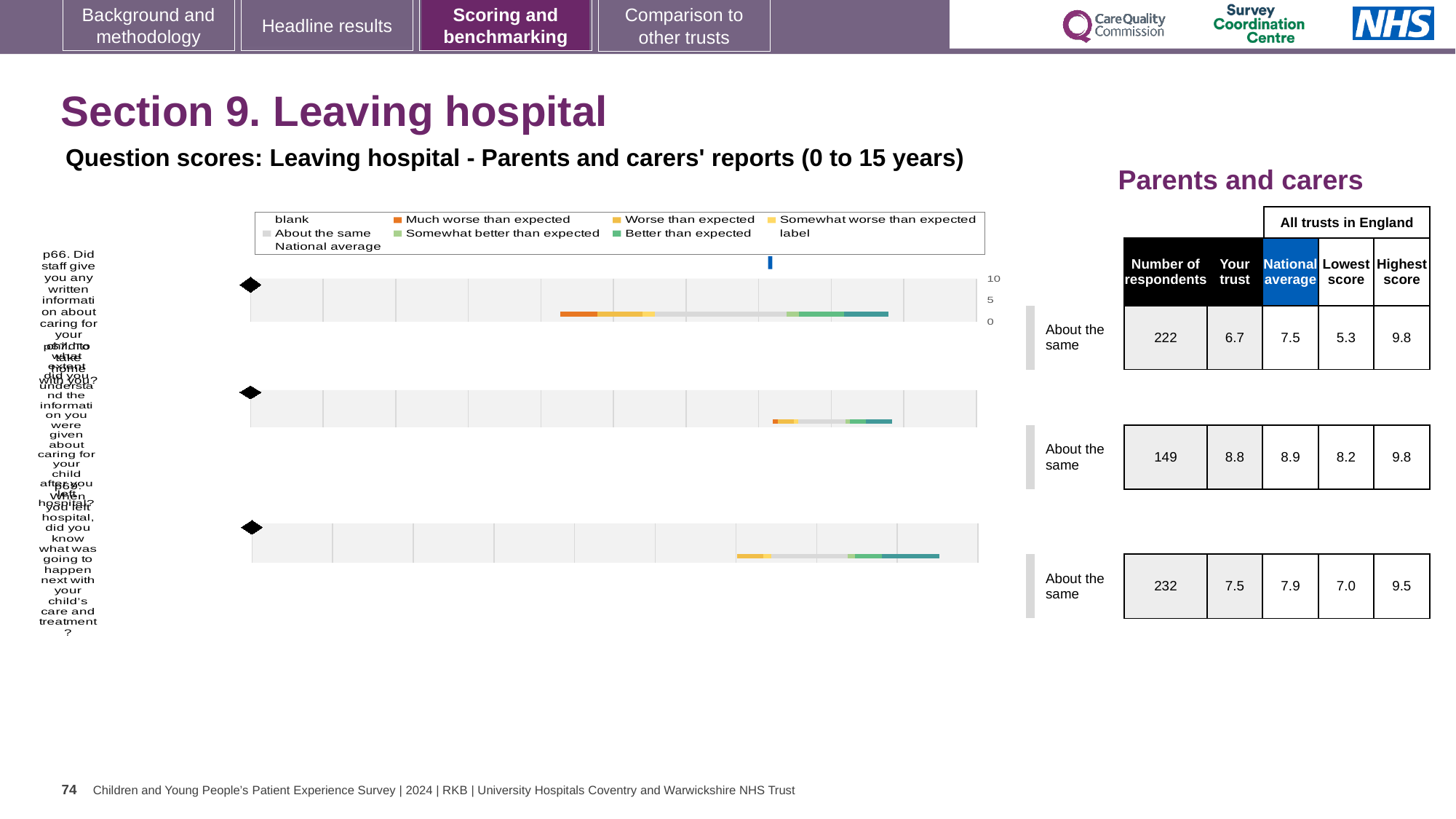
For the bottom chart, what is the difference between the highest score and the lowest score in the table? 2.5 What kind of chart is used to show the question scores on this slide? bar chart Which chart (top, middle or bottom) has the lowest 'Lowest score' value in the table? top How many question score bars are plotted on the slide? 3 Which chart (top, middle or bottom) has the highest 'Your trust' score? middle What benchmark category is shown next to the top chart? About the same For the middle chart, what is the national average shown in the table? 8.9 What colour represents 'Much worse than expected' in the legend? orange What is the maximum value shown on the chart axis? 10 For the top chart, what is the 'Your trust' score shown in the table? 6.7 For the top chart, which is larger: the 'Your trust' score or the national average? National average For the bottom chart, how many respondents are shown in the table? 232